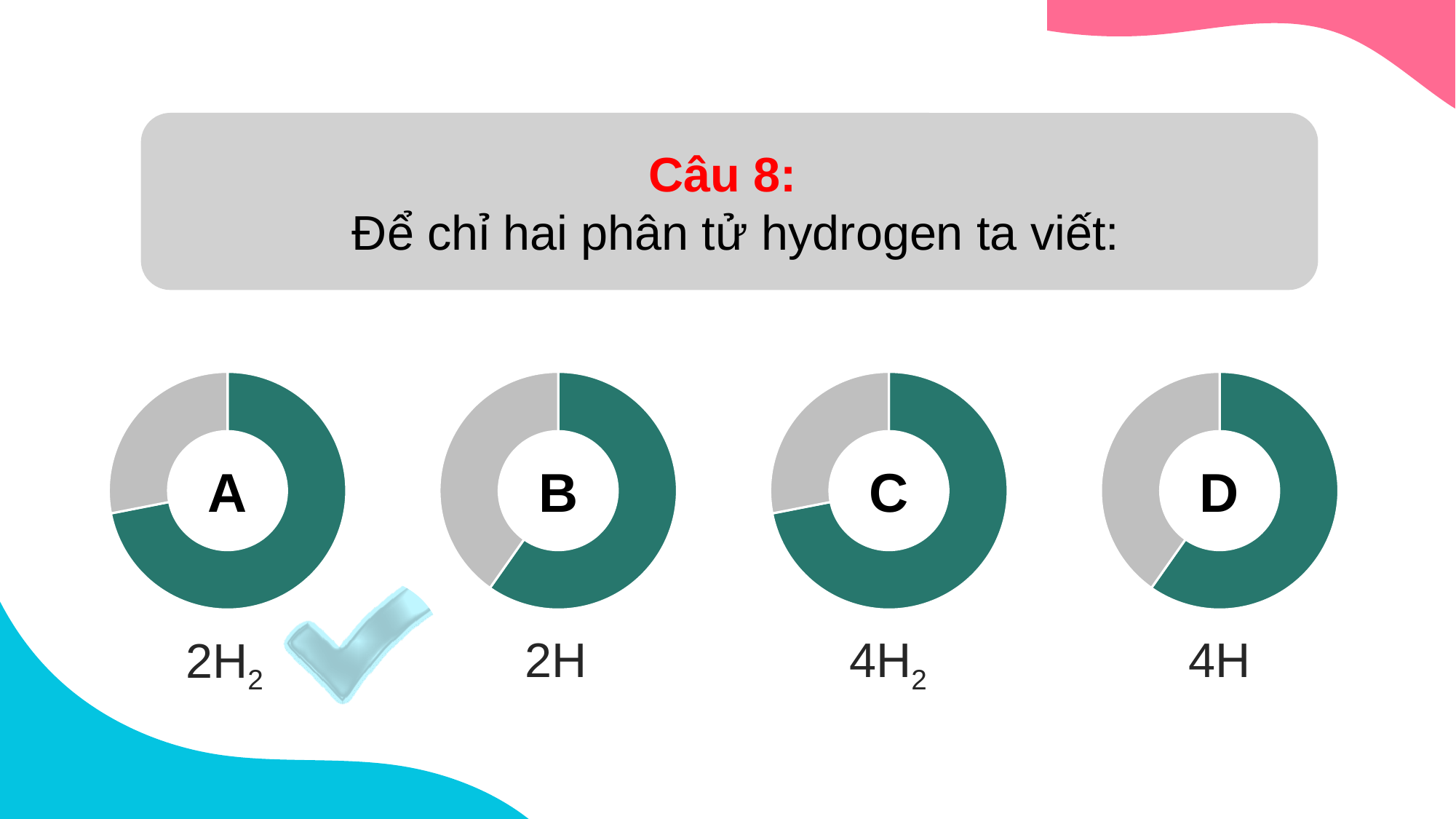
What letter is printed in the centre of the leftmost donut chart? A What kind of chart is used for option A on the slide? pie chart (donut) In the chart labelled A, which segment is larger, the green one or the grey one? green What text appears below the chart labelled C? 4H₂ In the chart labelled D, which segment is larger, the green one or the grey one? green How many segments does the chart labelled A have? 2 In the chart labelled C, which segment is larger, the green one or the grey one? green How many donut charts are shown on the slide? 4